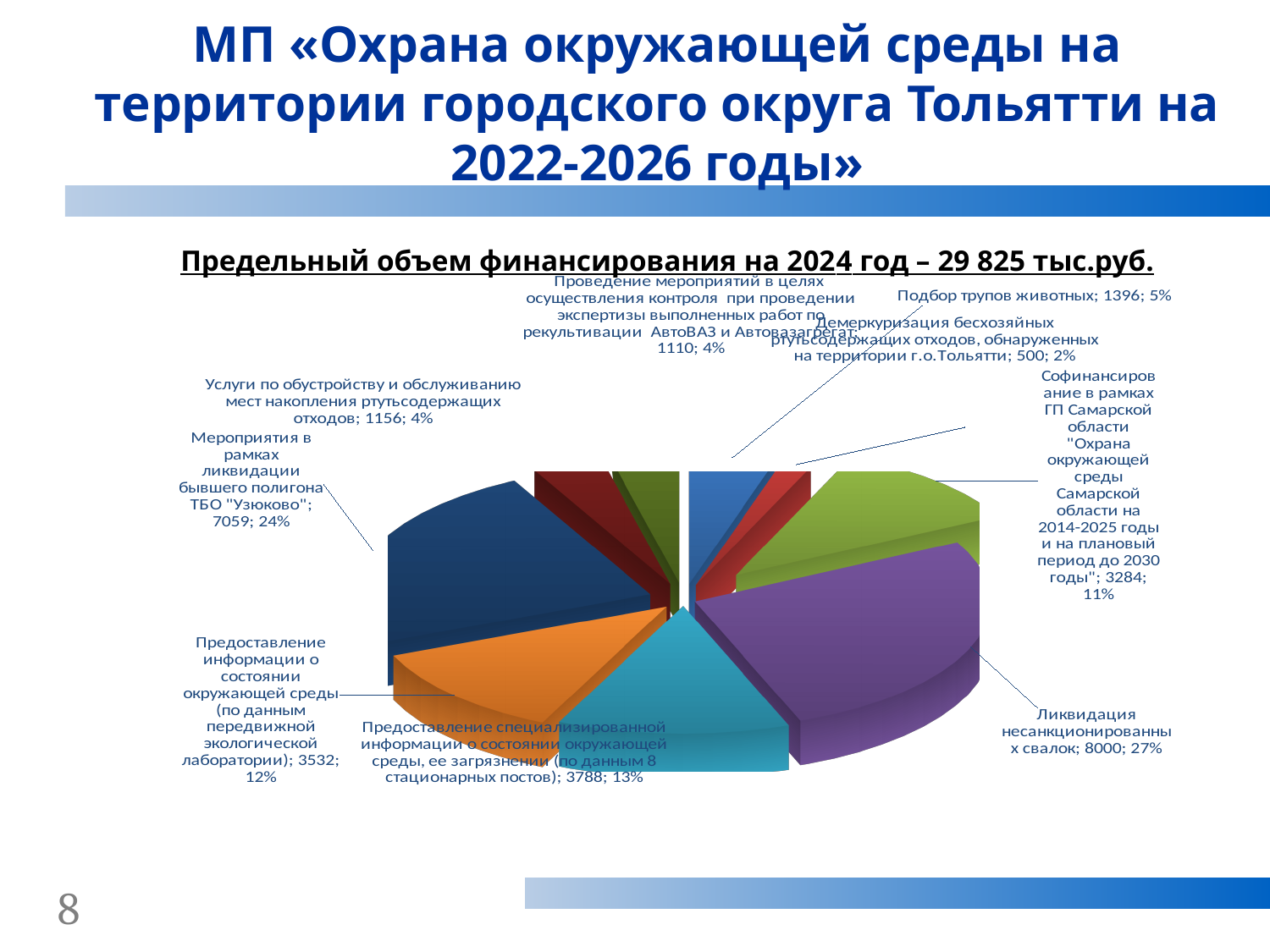
What kind of chart is shown on the slide? Pie chart Which category has the largest slice of the pie chart? Ликвидация несанкционированных свалок What share of the pie does "Софинансирование в рамках ГП Самарской области" represent? 11% What total funding amount for 2024 is stated in the chart heading? 29 825 тыс.руб. Which category has the smallest slice of the pie chart? Демеркуризация бесхозяйных ртутьсодержащих отходов, обнаруженных на территории г.о.Тольятти What is the difference between the values for "Ликвидация несанкционированных свалок" and "Мероприятия в рамках ликвидации бывшего полигона ТБО "Узюково""? 941 Which is larger: the value for "Предоставление информации о состоянии окружающей среды (по данным передвижной экологической лаборатории)" or the value for "Подбор трупов животных"? Предоставление информации о состоянии окружающей среды (по данным передвижной экологической лаборатории) What is the value for "Подбор трупов животных"? 1396 How many slices does the pie chart have? 9 What is the value for "Ликвидация несанкционированных свалок"? 8000 What share of the pie does "Предоставление специализированной информации о состоянии окружающей среды, ее загрязнении (по данным 8 стационарных постов)" represent? 13% What is the value for "Мероприятия в рамках ликвидации бывшего полигона ТБО "Узюково""? 7059